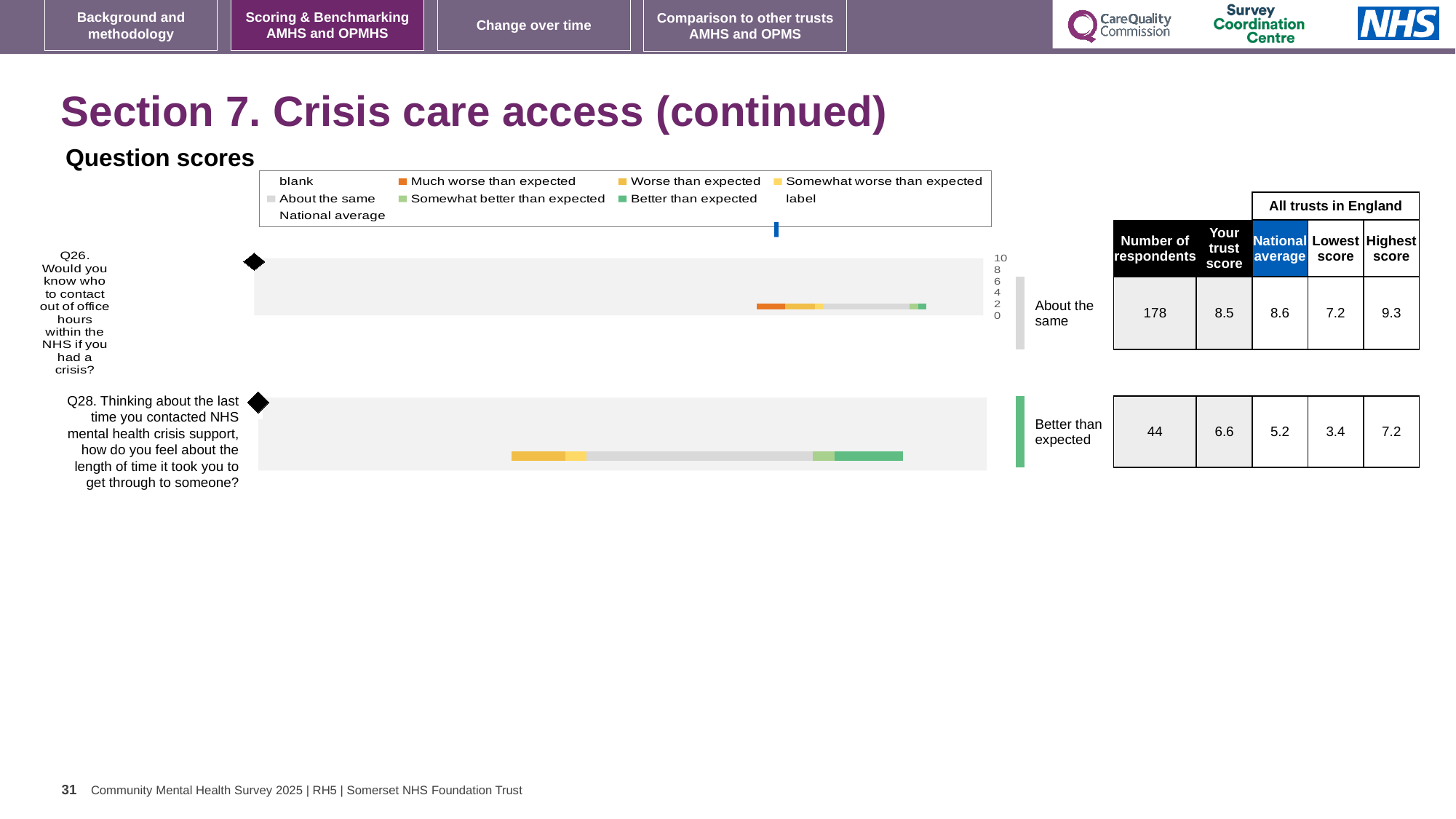
How many respondents answered Q28? 44 What is the national average score for Q26? 8.6 For Q28, which is larger: the trust score or the national average? the trust score (6.6) How many questions are plotted in the question scores chart? 2 What is the difference between the trust score and the national average for Q28? 1.4 How many respondents answered Q26? 178 What is the 'Your trust score' for Q26 (Would you know who to contact out of office hours within the NHS if you had a crisis?)? 8.5 What benchmark category is shown next to the Q28 bar? Better than expected What is the difference between the highest and lowest scores among all trusts in England for Q26? 2.1 What is the highest score among all trusts in England for Q28? 7.2 What kind of chart is used to show the question scores on this slide? bar chart What is the 'Your trust score' for Q28 (length of time it took to get through to someone)? 6.6